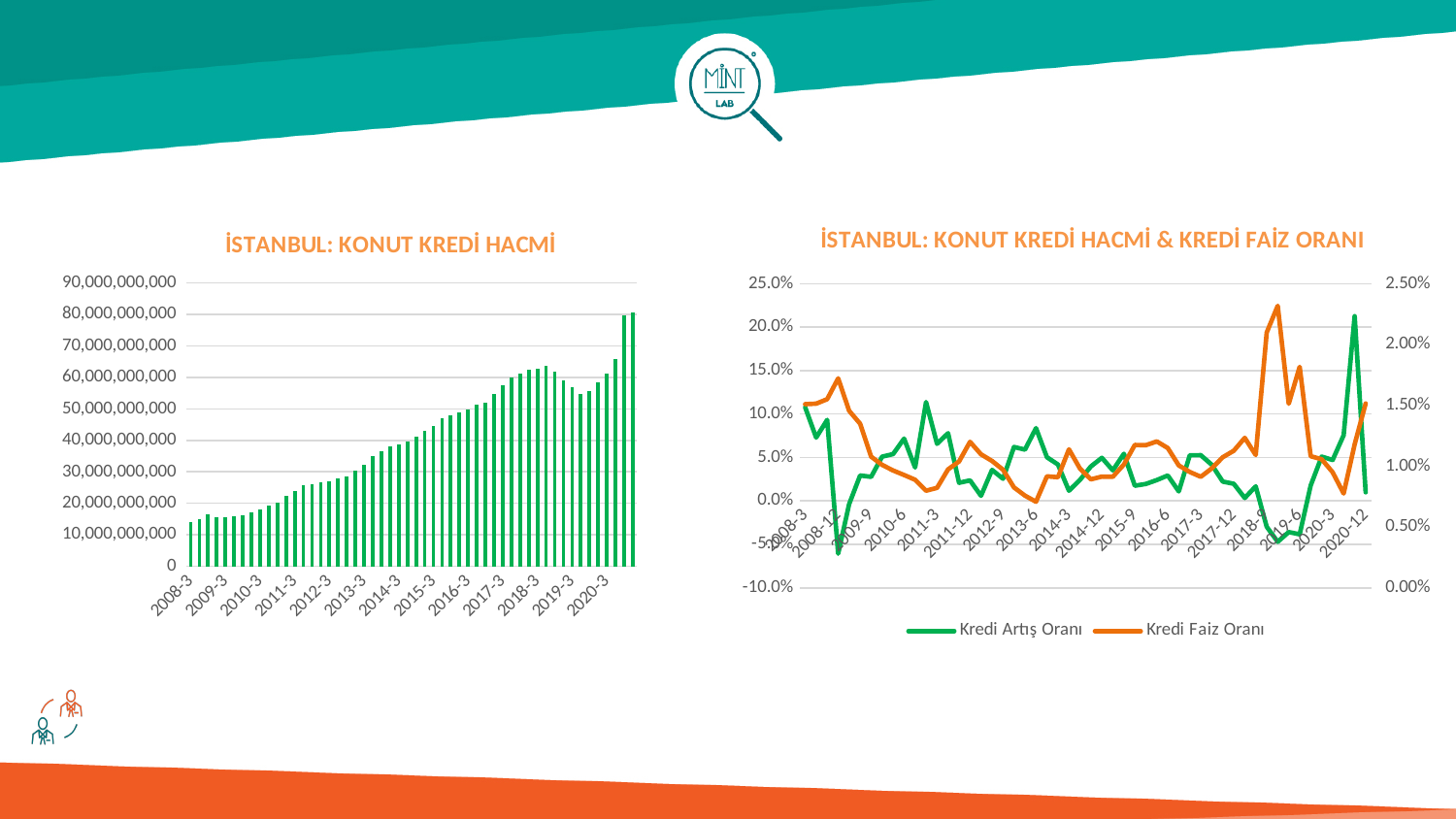
In the right chart 'İSTANBUL: KONUT KREDİ HACMİ & KREDİ FAİZ ORANI', which series is drawn in green? Kredi Artış Oranı How many series does the legend of the right chart 'İSTANBUL: KONUT KREDİ HACMİ & KREDİ FAİZ ORANI' list? 2 What kind of chart is the right chart titled 'İSTANBUL: KONUT KREDİ HACMİ & KREDİ FAİZ ORANI'? line chart In the right chart 'İSTANBUL: KONUT KREDİ HACMİ & KREDİ FAİZ ORANI', is the lowest value of Kredi Artış Oranı near 2008-12 greater or less than 0.0%? less In the left chart 'İSTANBUL: KONUT KREDİ HACMİ', is the value for 2012-3 greater or less than 30,000,000,000? less In the left chart 'İSTANBUL: KONUT KREDİ HACMİ', is the value of the last bar greater or less than 70,000,000,000? greater In the left chart 'İSTANBUL: KONUT KREDİ HACMİ', which is larger, the value for 2010-3 or the value for 2016-3? 2016-3 In the left chart 'İSTANBUL: KONUT KREDİ HACMİ', do the values generally rise or fall from 2008-3 to 2020-3? rise What kind of chart is the left chart titled 'İSTANBUL: KONUT KREDİ HACMİ'? bar chart